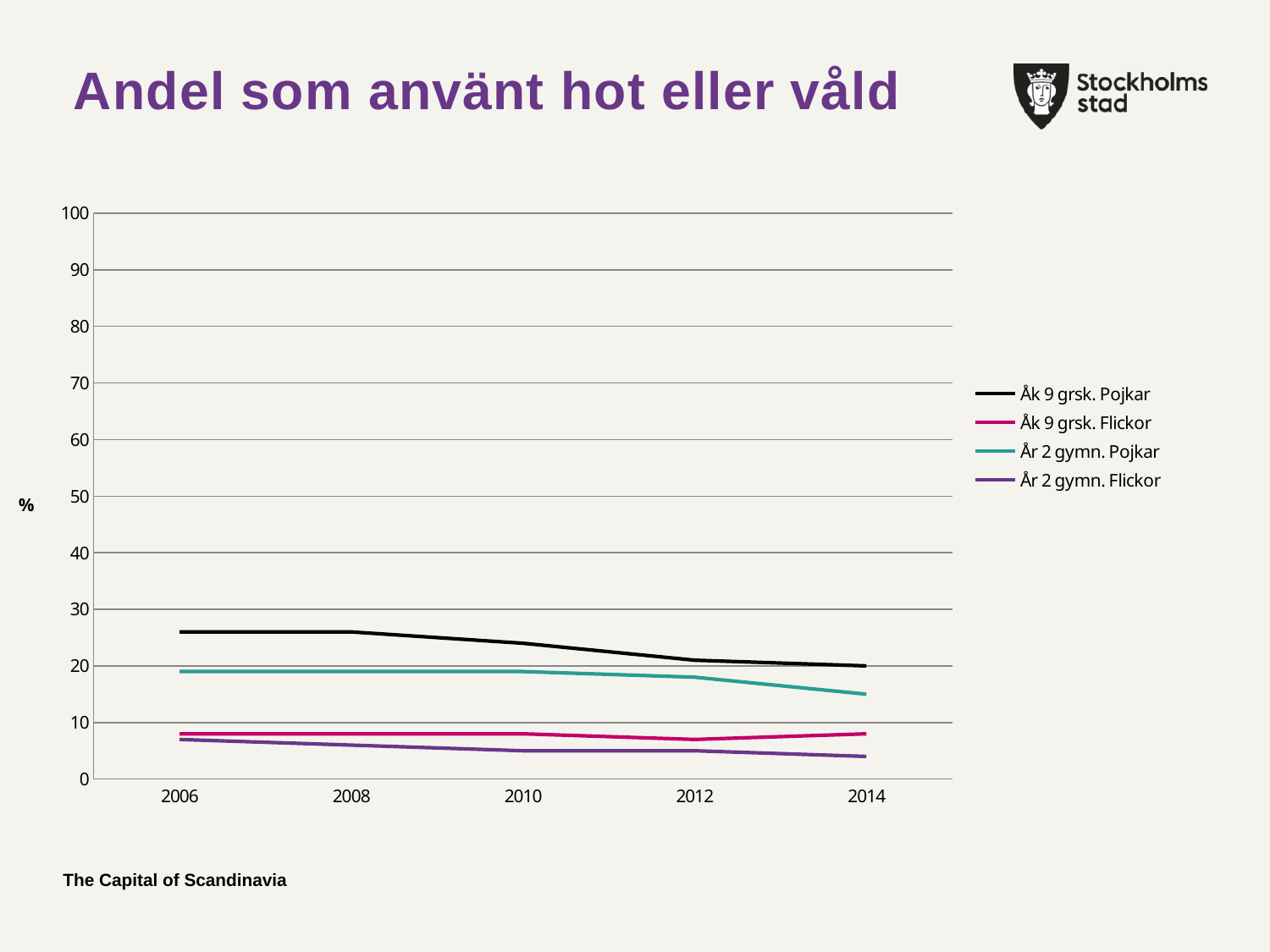
Is the value for Åk 9 grsk. Flickor in 2010 greater or less than 10? less How many years are shown on the x axis? 5 Does the Åk 9 grsk. Pojkar line rise or fall from 2006 to 2014? fall Which series has the lowest value in 2014? År 2 gymn. Flickor What kind of chart is shown on the slide? line chart What is the title of the slide? Andel som använt hot eller våld Is the value for År 2 gymn. Pojkar in 2014 greater or less than 20? less How many series does the legend list? 4 Is the value for Åk 9 grsk. Pojkar in 2006 greater or less than 20? greater In 2014, which is larger: Åk 9 grsk. Pojkar or År 2 gymn. Pojkar? Åk 9 grsk. Pojkar Which series has the highest value in 2006? Åk 9 grsk. Pojkar What is the label on the y axis? %